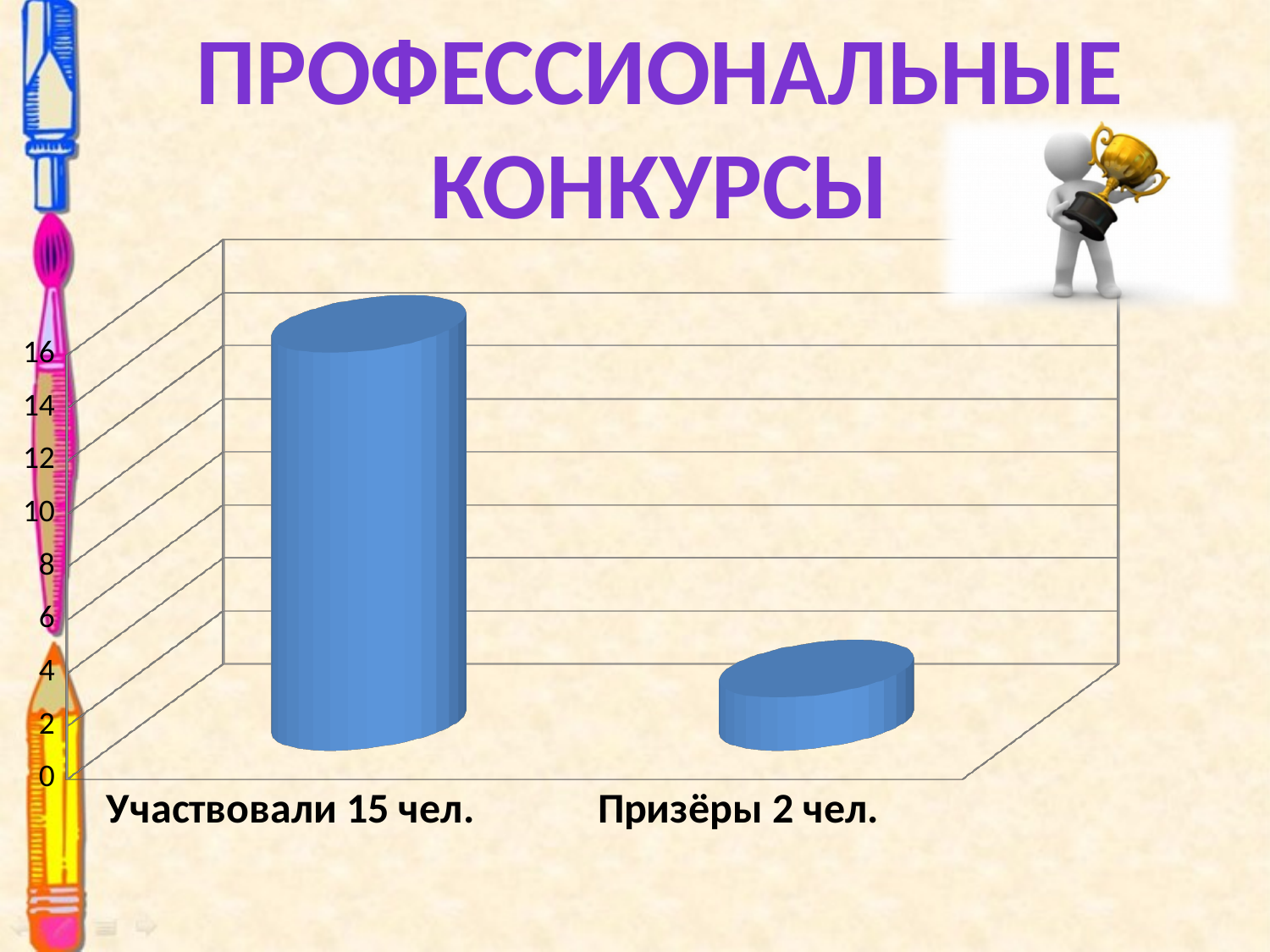
Do the bar values rise or fall from left to right along the x axis? fall How many people participated according to the label "Участвовали"? 15 чел. How many categories does the chart show? 2 How many prize-winners are shown according to the label "Призёры"? 2 чел. Which category has the lowest bar? Призёры 2 чел. Which is larger, the bar for Участвовали or the bar for Призёры? Участвовали Is the value for Участвовали greater or less than 10? greater Is the value for Призёры greater or less than 4? less What is the title of the slide with the chart? ПРОФЕССИОНАЛЬНЫЕ КОНКУРСЫ Which category has the highest bar? Участвовали 15 чел. What type of chart is shown on the slide? bar chart What is the difference between the number of participants (Участвовали) and the number of prize-winners (Призёры)? 13